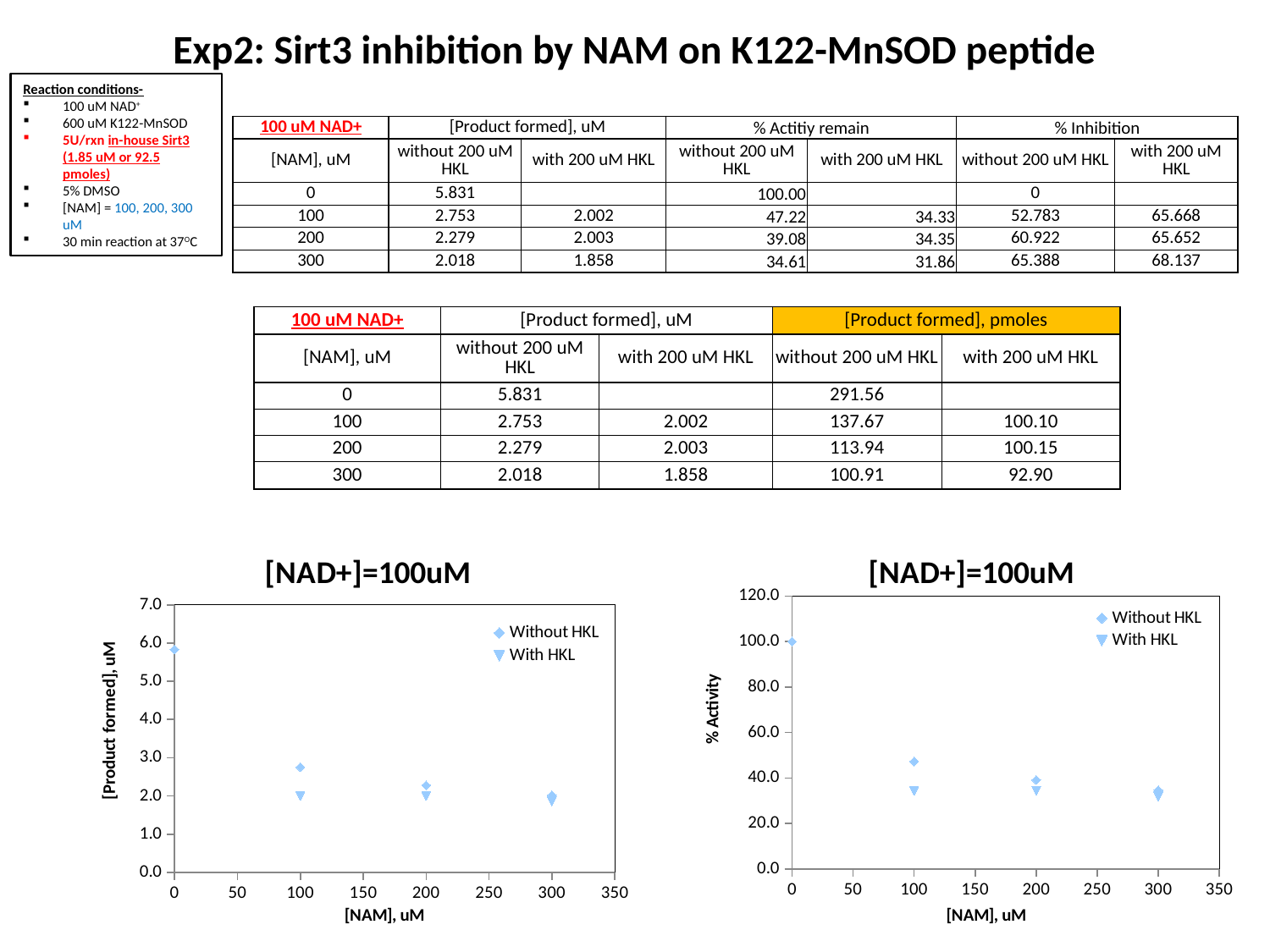
On the left chart, is the Without HKL value at [NAM] = 0 greater or less than 5.0? greater On the right chart, what is the % Activity value for Without HKL at [NAM] = 0? 100.0 What are the two legend entries on the right chart? Without HKL, With HKL How many series does the legend of the left chart list? 2 On the left chart, do the Without HKL values rise or fall as [NAM] increases? fall On the left chart, how many points are plotted for the Without HKL series? 4 What is the y-axis label of the right chart? % Activity On the right chart, is the Without HKL value at [NAM] = 100 greater or less than 40.0? greater What type of chart is the left chart titled [NAD+]=100uM? scatter chart On the left chart, is the Without HKL value at [NAM] = 100 greater or less than 3.0? less On the right chart, at [NAM] = 100, which series has the higher % Activity, Without HKL or With HKL? Without HKL On the right chart, how many points are plotted for the With HKL series? 3